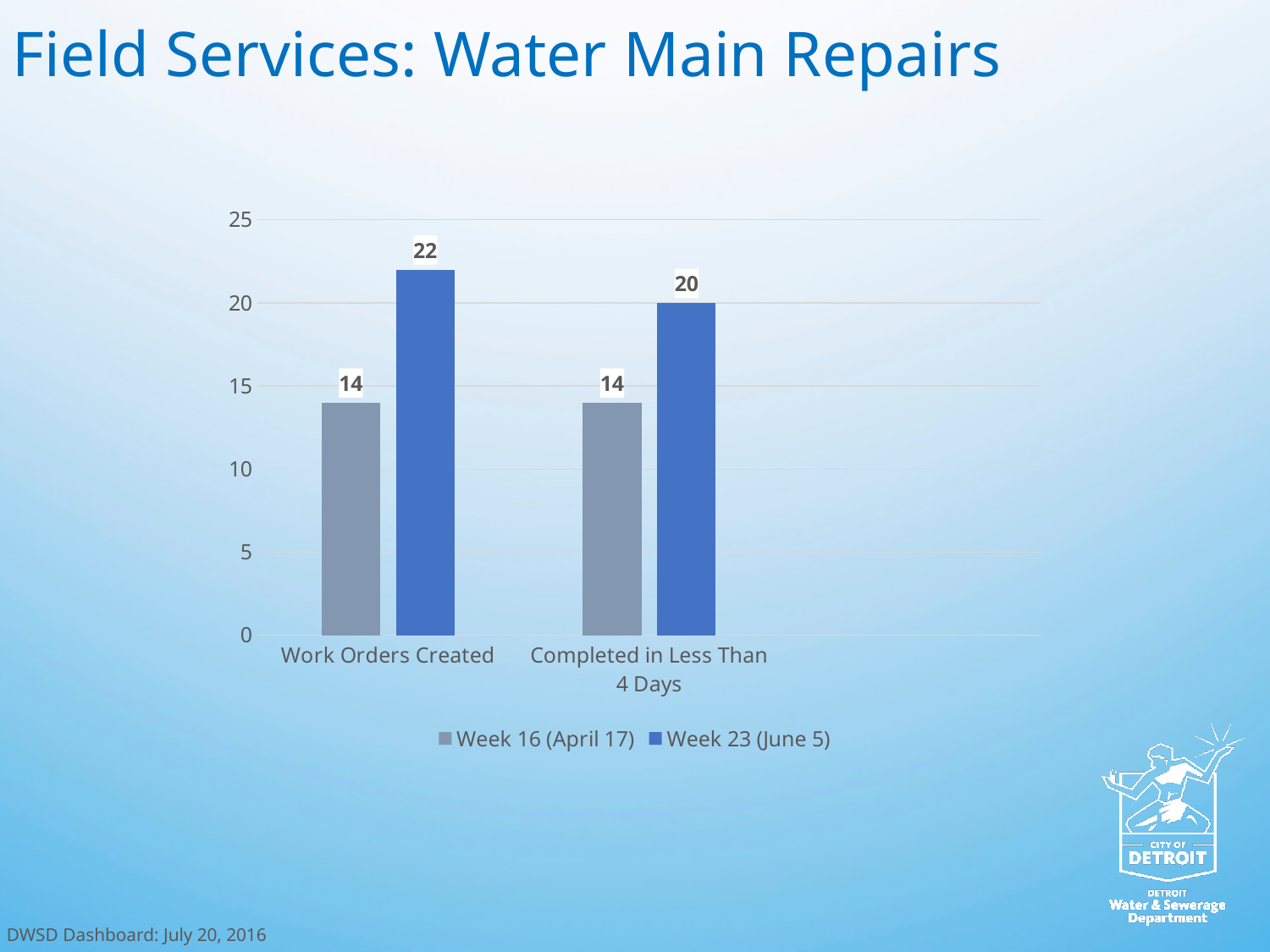
What is the difference between Work Orders Created in Week 23 (June 5) and Week 16 (April 17)? 8 How many categories are shown on the x axis? 2 What is the difference between Work Orders Created and Completed in Less Than 4 Days for Week 23 (June 5)? 2 What is the title of the slide containing the chart? Field Services: Water Main Repairs What kind of chart is shown on the slide? Bar chart Which is larger for Completed in Less Than 4 Days: Week 16 (April 17) or Week 23 (June 5)? Week 23 (June 5) What is the value for Completed in Less Than 4 Days in Week 16 (April 17)? 14 How many series does the legend list? 2 What is the value for Work Orders Created in Week 16 (April 17)? 14 Which bar has the highest value on the chart? Work Orders Created, Week 23 (June 5) What is the value for Completed in Less Than 4 Days in Week 23 (June 5)? 20 What is the value for Work Orders Created in Week 23 (June 5)? 22